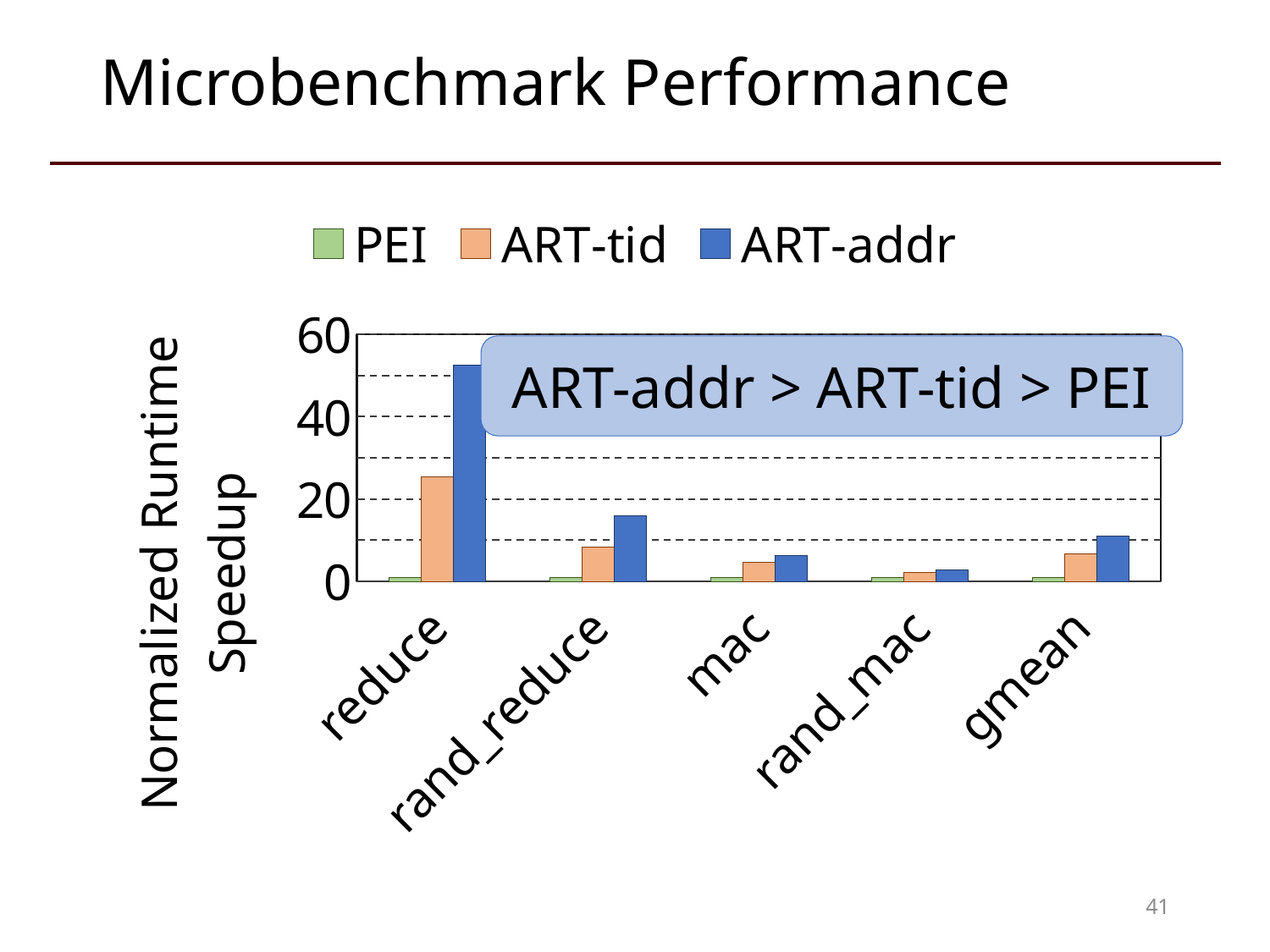
Is the ART-tid value for reduce greater or less than 20? greater For rand_reduce, which is larger: the ART-tid bar or the ART-addr bar? ART-addr Which benchmark has the highest ART-addr bar? reduce How many benchmark categories are shown on the x axis? 5 How many series does the legend list? 3 Is the ART-addr value for rand_reduce greater or less than 20? less Which series is shown in blue in the legend? ART-addr Is the ART-addr value for reduce greater or less than 40? greater Which benchmark has the lowest ART-addr bar? rand_mac What is the label on the y axis? Normalized Runtime Speedup What kind of chart is shown on the slide? bar chart